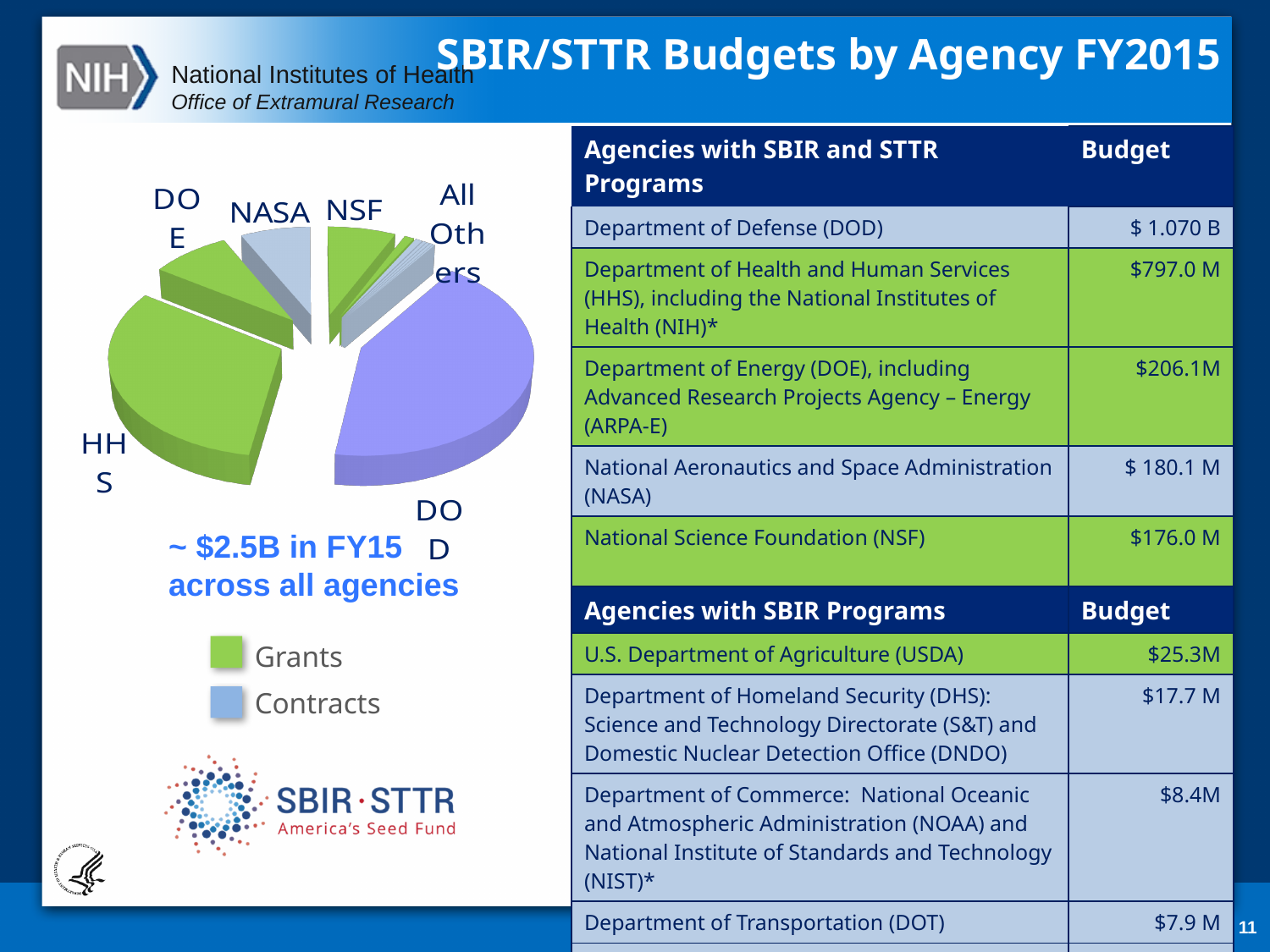
In the pie chart, which slice is larger, HHS or DOE? HHS According to the legend, what colour represents Grants in the pie chart? green How many entries does the pie chart's legend list? 2 Which agency has the largest slice in the pie chart? DOD In the pie chart, which slice is larger, HHS or NASA? HHS What is the title of the slide containing the pie chart? SBIR/STTR Budgets by Agency FY2015 What are the two legend entries of the pie chart? Grants and Contracts What kind of chart is shown on the slide? pie chart In the pie chart, which slice is larger, DOD or HHS? DOD